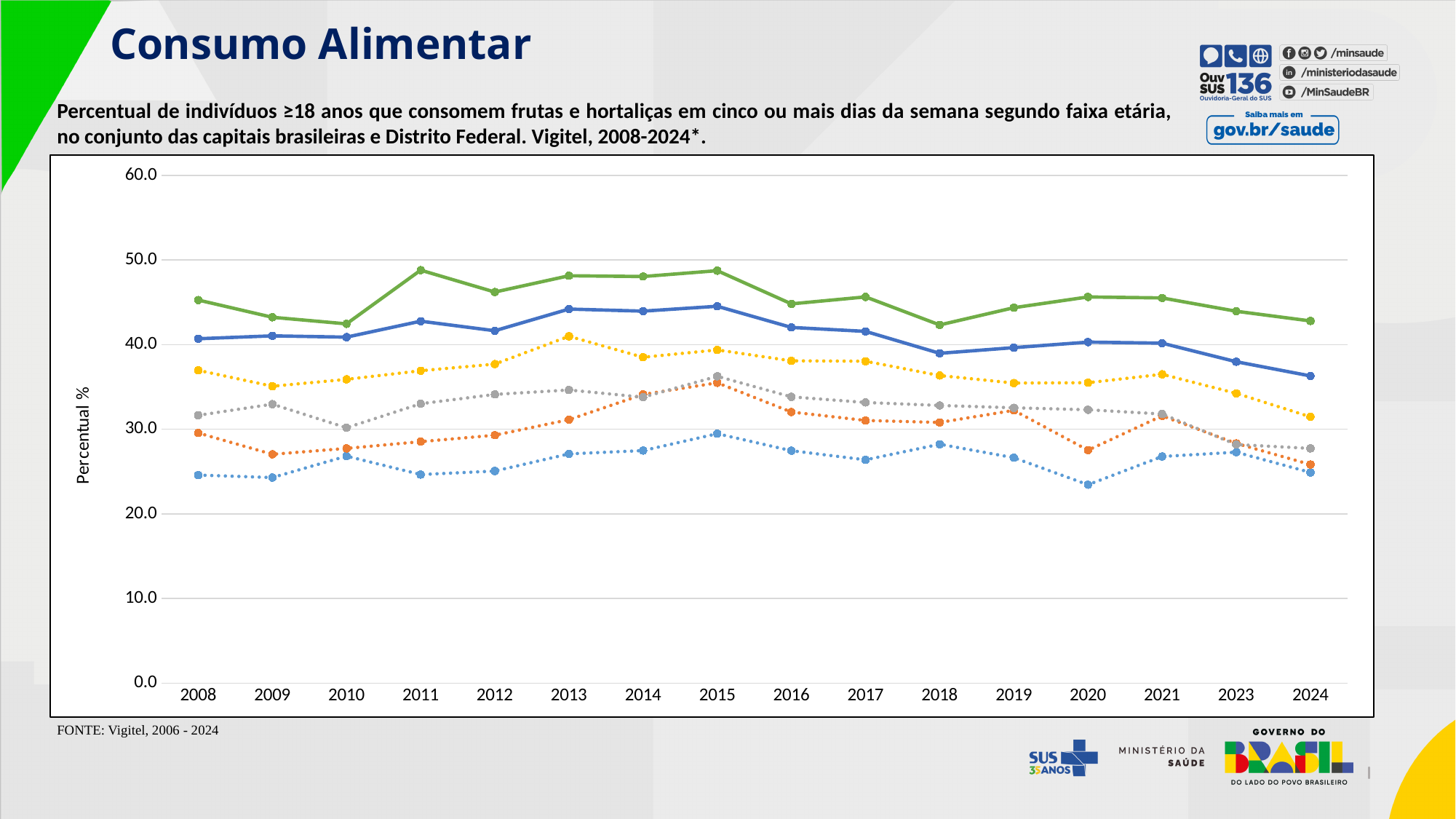
Does the dark blue line rise or fall from 2021 to 2024? fall Is the value of the orange dotted line in 2015 greater or less than 30.0? greater Is the value of the yellow dotted line in 2024 greater or less than 40.0? less In 2008, is the green line higher or lower than the dark blue line? higher How many lines are plotted on the chart? 6 How many years are shown on the x axis of the chart? 16 Is the value of the green line in 2011 greater or less than 40.0? greater In 2024, is the dark blue line higher or lower than the yellow dotted line? higher What is the label of the y axis? Percentual % What kind of chart is shown on the slide? line chart Which year is missing from the x axis between 2021 and 2023? 2022